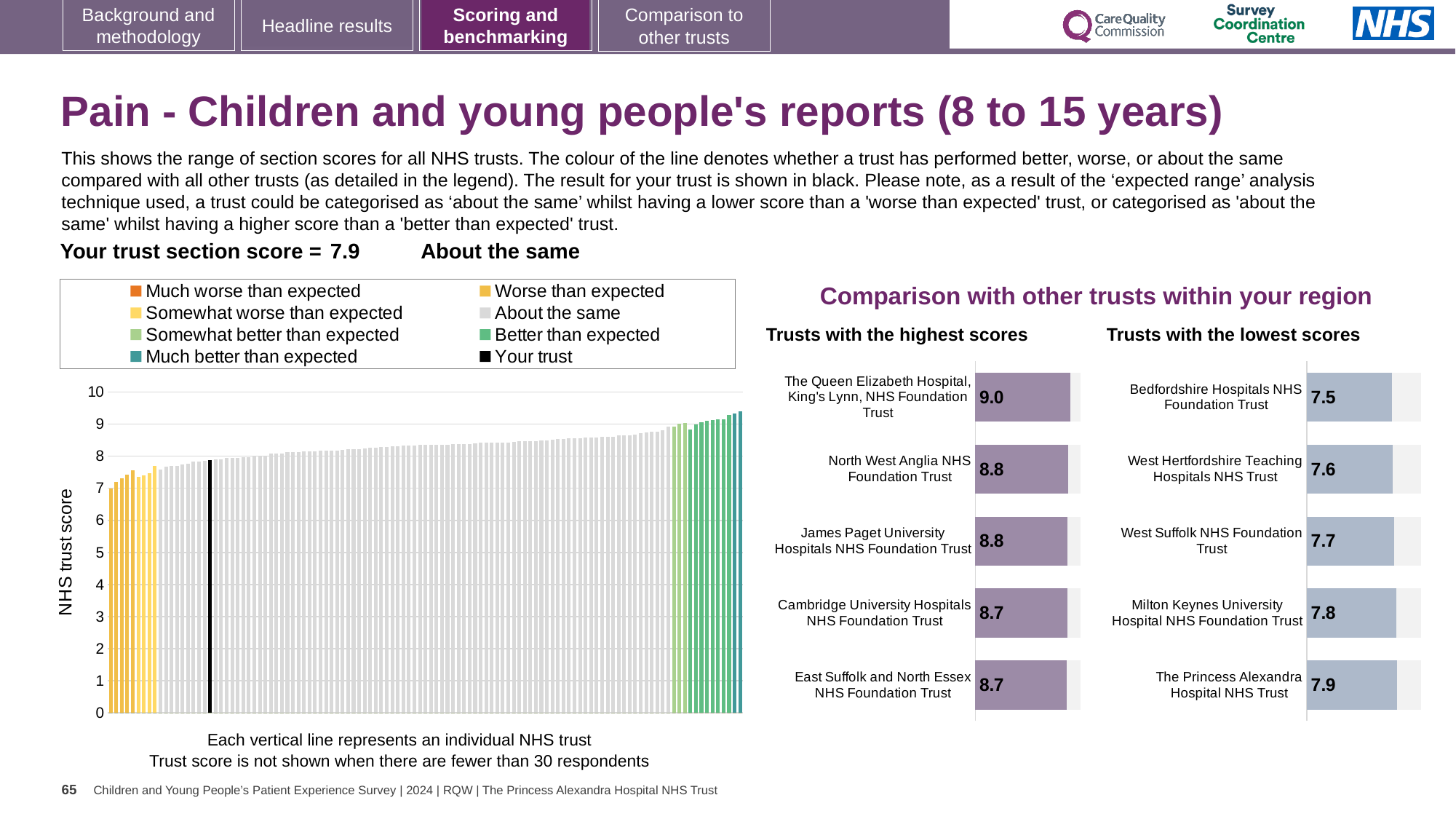
In the 'Trusts with the highest scores' chart, what is the score for The Queen Elizabeth Hospital, King's Lynn, NHS Foundation Trust? 9.0 How many entries does the legend above the 'NHS trust score' chart list? 8 How many trusts are listed in the 'Trusts with the highest scores' chart? 5 In the 'NHS trust score' chart on the left, is the value of the leftmost bar greater or less than 8? less In the 'Trusts with the highest scores' chart, which trust has the highest score? The Queen Elizabeth Hospital, King's Lynn, NHS Foundation Trust In the 'Trusts with the highest scores' chart, which has the higher score: North West Anglia NHS Foundation Trust or Cambridge University Hospitals NHS Foundation Trust? North West Anglia NHS Foundation Trust In the 'Trusts with the lowest scores' chart, what is the score for The Princess Alexandra Hospital NHS Trust? 7.9 What kind of chart is the 'NHS trust score' chart on the left of the slide? Bar chart In the 'NHS trust score' chart on the left, do the bar heights rise or fall from left to right? Rise In the 'Trusts with the lowest scores' chart, which trust has the lowest score? Bedfordshire Hospitals NHS Foundation Trust In the 'Trusts with the lowest scores' chart, what is the score for Bedfordshire Hospitals NHS Foundation Trust? 7.5 In the 'Trusts with the highest scores' chart, what is the difference between the scores of The Queen Elizabeth Hospital, King's Lynn and East Suffolk and North Essex NHS Foundation Trust? 0.3